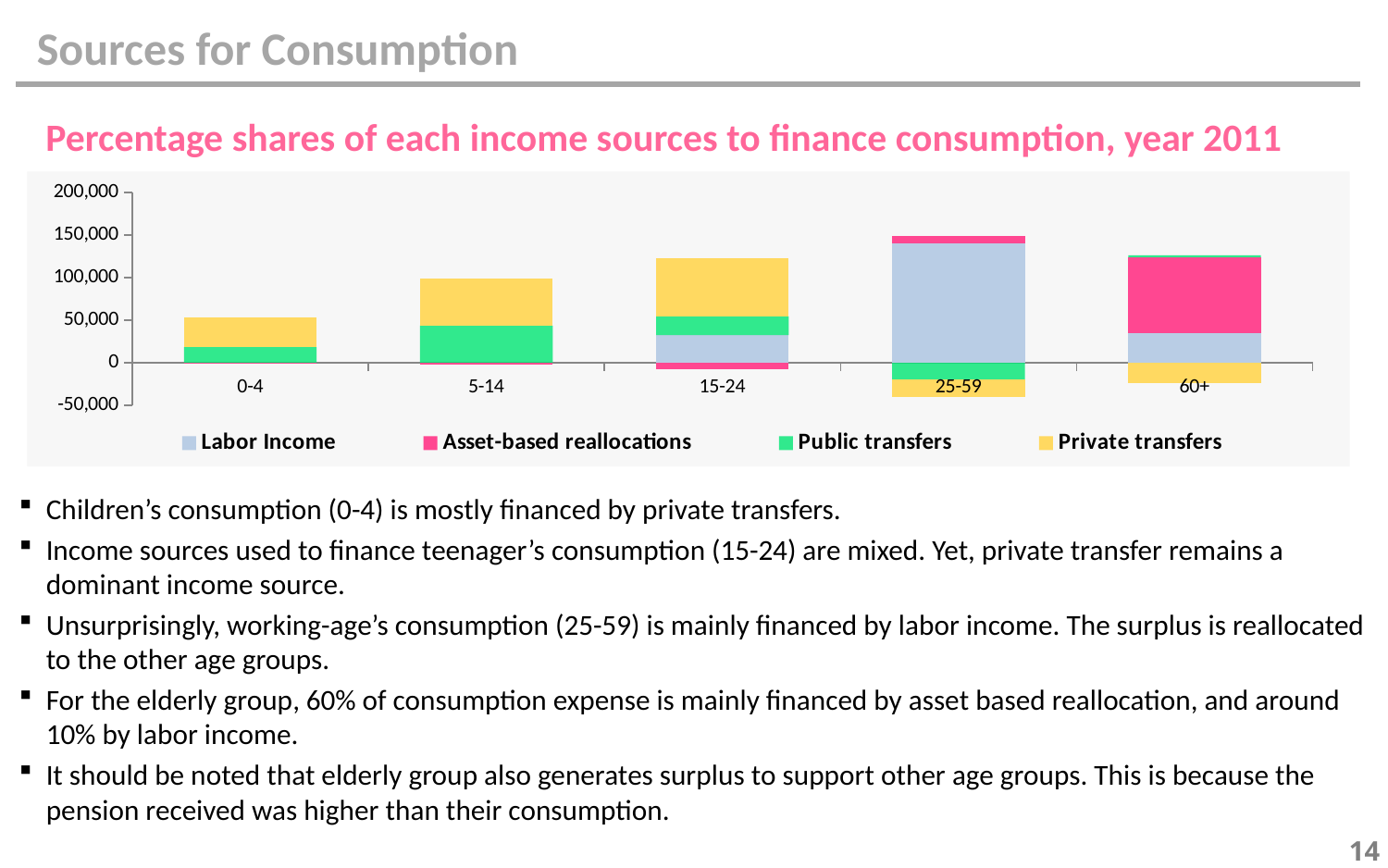
Which age group has the larger Labor Income value, 25-59 or 60+? 25-59 Which age group has the largest Asset-based reallocations value? 60+ Which age group has the largest Labor Income value? 25-59 What kind of chart is shown on the slide? Stacked bar chart How many series does the chart's legend list? 4 How many age groups are shown on the x axis of the chart? 5 Is the Asset-based reallocations value for the 60+ age group greater or less than 50,000? greater Is the Private transfers value for the 0-4 age group greater or less than 50,000? less Is the Labor Income value for the 25-59 age group greater or less than 100,000? greater What is the title of the chart? Percentage shares of each income sources to finance consumption, year 2011 Which series is shown in light blue in the chart? Labor Income Which age group has the larger Private transfers value, 0-4 or 5-14? 5-14